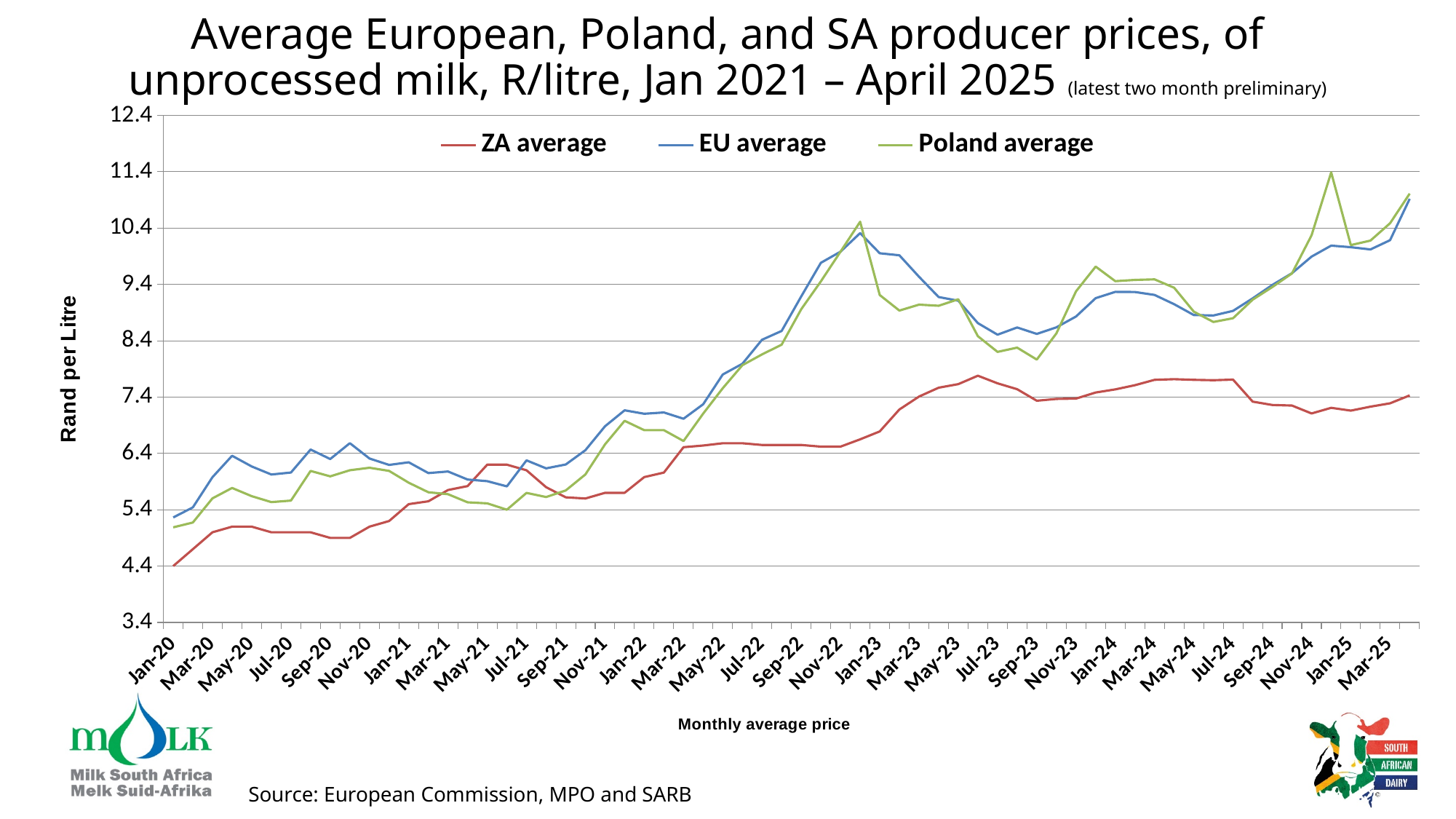
Which series reaches the highest value anywhere on the chart? Poland average Is the value for Poland average in Jul-21 greater or less than 6.4? less How many series does the legend list? 3 In Jan-23, which is larger, the EU average or the Poland average? EU average Is the value for EU average in Nov-22 greater or less than 9.4? greater Which series is drawn in green in the chart? Poland average Does the ZA average rise or fall from Jan-20 to Jul-23? Rise What is the label on the vertical axis of the chart? Rand per Litre Is the value for ZA average in Jul-23 greater or less than 7.4? greater In Jan-20, which is larger, the EU average or the ZA average? EU average What kind of chart is shown on the slide? Line chart